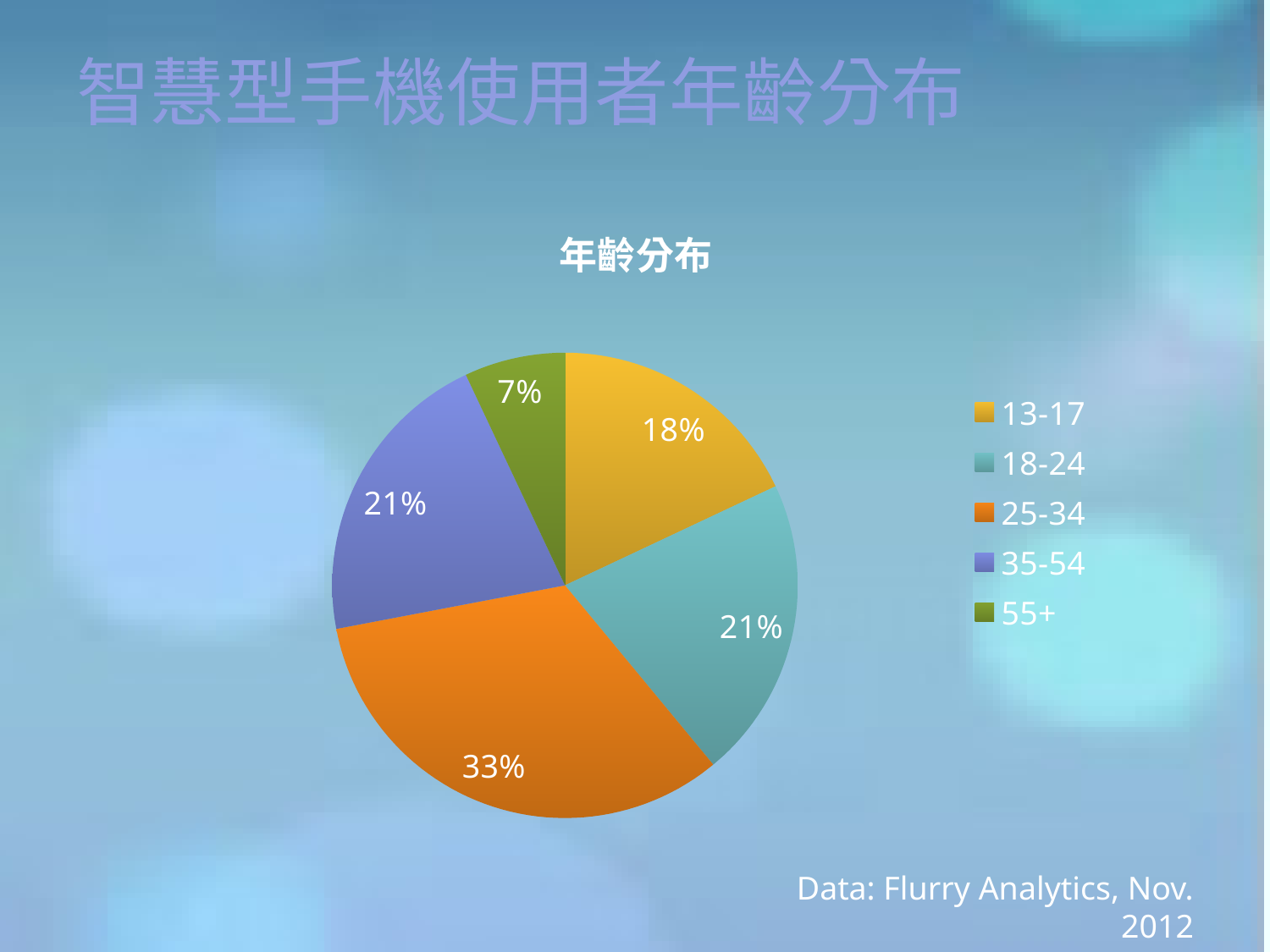
What share of smartphone users is in the 55+ age group? 7% What is the chart's title? 年齡分布 Which age group has the largest share of the pie? 25-34 What share of smartphone users is in the 13-17 age group? 18% Which age group has the smallest share of the pie? 55+ What kind of chart is shown on the slide? pie chart How many age groups does the legend list? 5 What share of smartphone users is in the 25-34 age group? 33% What is the difference between the shares of the 25-34 and 13-17 age groups? 15% What is the combined share of the 18-24 and 35-54 age groups? 42% What share of smartphone users is in the 35-54 age group? 21% Which has a larger share, the 13-17 group or the 55+ group? 13-17